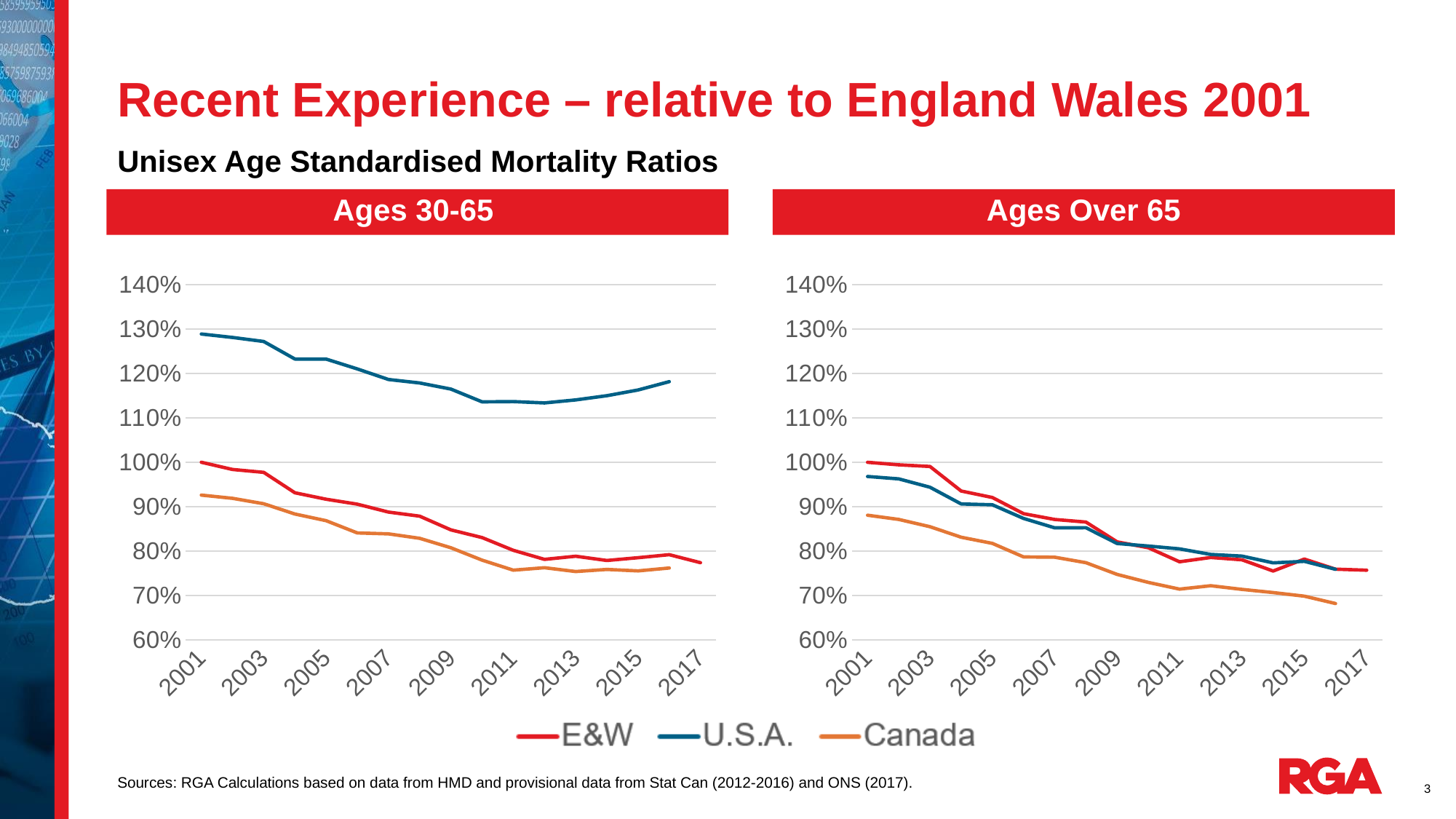
In the 'Ages 30-65' chart, which series has the highest values across the whole period? U.S.A. Which series are listed in the legend? E&W, U.S.A., Canada In the 'Ages Over 65' chart, which series has the lowest values across the whole period? Canada In the 'Ages 30-65' chart, is the value for U.S.A. in 2001 greater or less than 120%? greater In the 'Ages 30-65' chart, which is larger in 2009, U.S.A. or Canada? U.S.A. In the 'Ages Over 65' chart, does the E&W line rise or fall from 2001 to 2017? fall How many series does the legend list? 3 In the 'Ages 30-65' chart, what is the value for E&W in 2001? 100% In the 'Ages 30-65' chart, is the value for U.S.A. in 2012 greater or less than 120%? less In the 'Ages 30-65' chart, is the value for Canada in 2016 greater or less than 80%? less What kind of chart is the 'Ages 30-65' chart? line chart